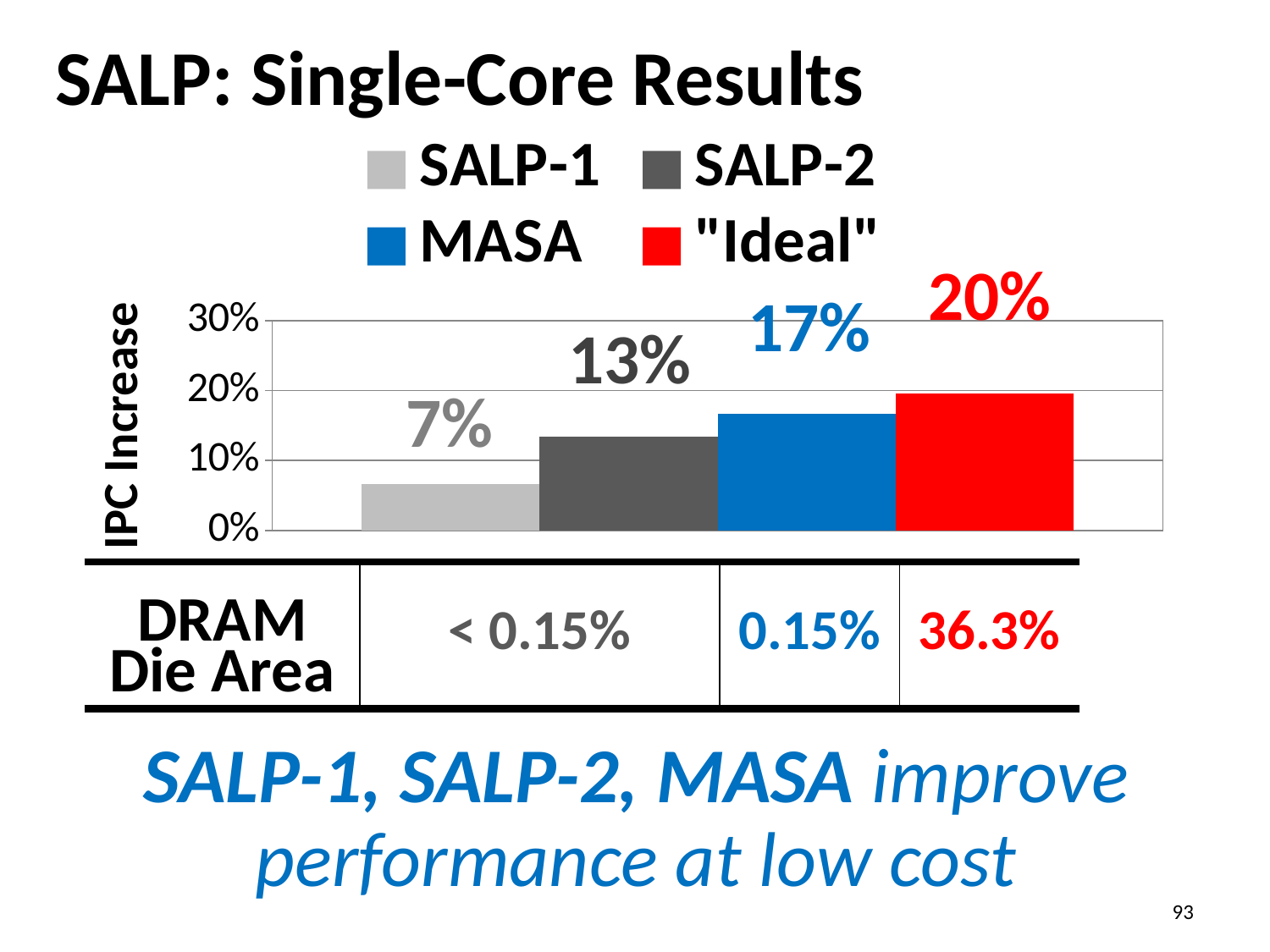
Which series has the lowest IPC increase? SALP-1 What kind of chart is shown on the slide? Bar chart What is the IPC increase for "Ideal"? 20% What is the label of the y axis? IPC Increase What is the difference in IPC increase between MASA and SALP-1? 10% What is the difference in IPC increase between "Ideal" and SALP-2? 7% What is the IPC increase for SALP-2? 13% How many series does the legend list? 4 What is the IPC increase for MASA? 17% Which series has the highest IPC increase? "Ideal" Which has a larger IPC increase, SALP-2 or MASA? MASA What is the IPC increase for SALP-1? 7%